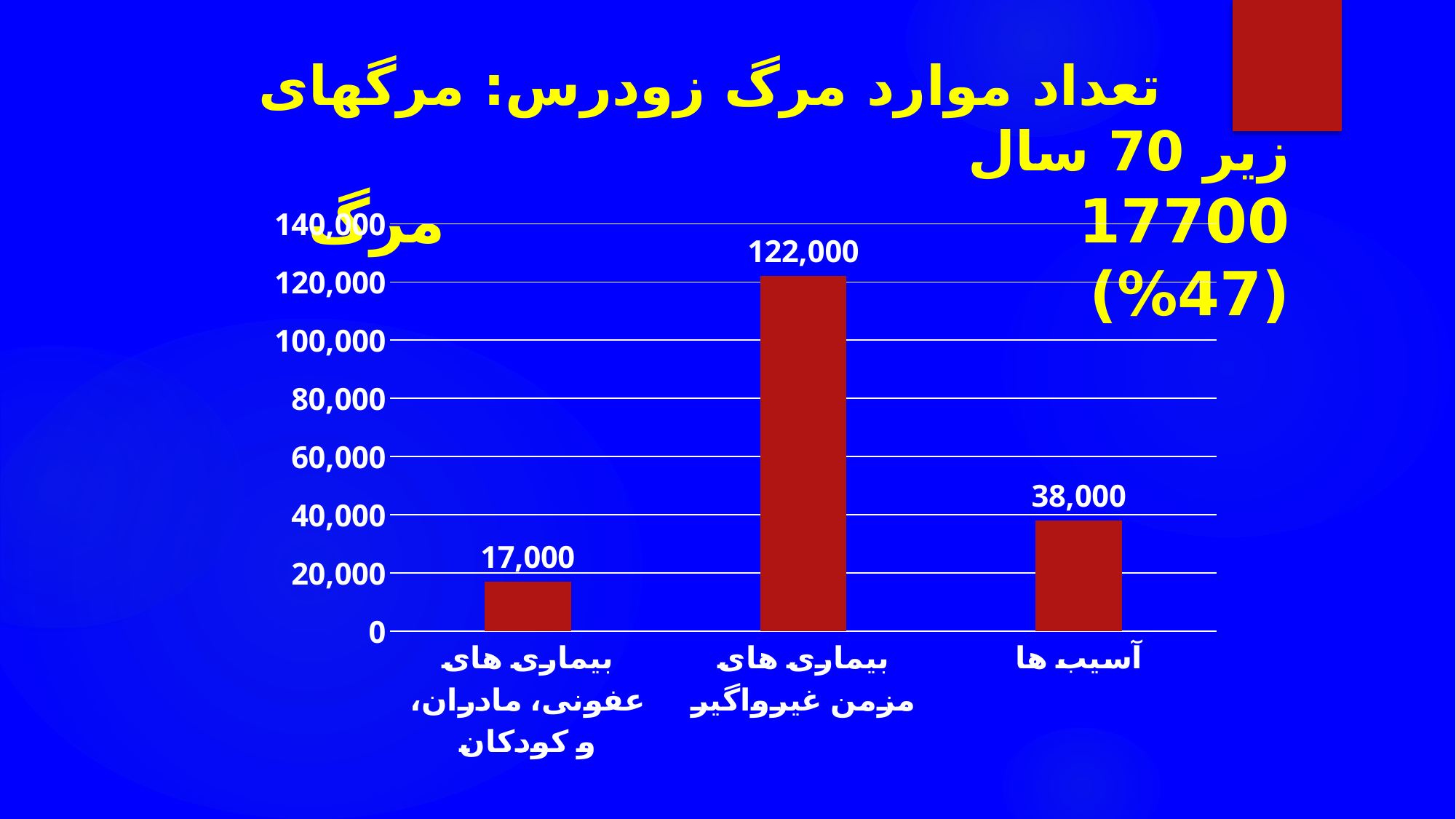
Is the value for بیماری های مزمن غیرواگیر greater or less than 100,000? greater Which category has the highest value? بیماری های مزمن غیرواگیر What is the difference between the values for آسیب ها and بیماری های عفونی، مادران، و کودکان? 21,000 What is the difference between the values for بیماری های مزمن غیرواگیر and آسیب ها? 84,000 Which category has the lowest value? بیماری های عفونی، مادران، و کودکان What kind of chart is shown on the slide? bar chart What is the value for آسیب ها? 38,000 What colour are the bars in the chart? red How many categories are shown in the chart? 3 What is the value for بیماری های عفونی، مادران، و کودکان? 17,000 Which is larger, the value for آسیب ها or the value for بیماری های عفونی، مادران، و کودکان? آسیب ها What is the value for بیماری های مزمن غیرواگیر? 122,000